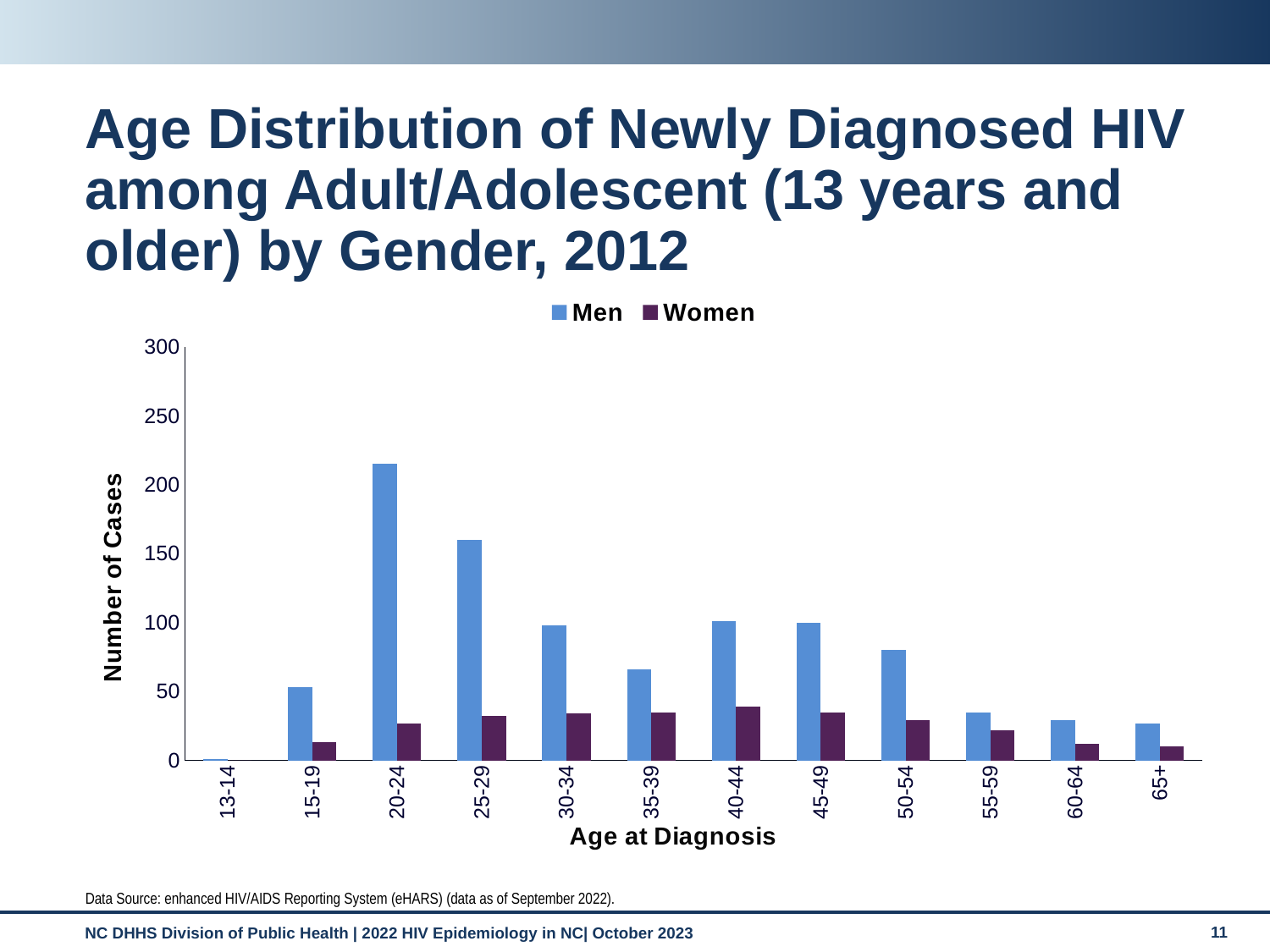
Which age group has the highest number of cases among men? 20-24 How many age groups are shown on the x axis? 12 Is the value for Men in the 25-29 age group greater or less than 150? greater How many series does the legend list? 2 What type of chart is shown on the slide? Bar chart Is the value for Men in the 55-59 age group greater or less than 50? less What is the title of the vertical axis? Number of Cases Is the value for Women in the 20-24 age group greater or less than 50? less Which is larger for Men: the 20-24 age group or the 25-29 age group? 20-24 In the 30-34 age group, which series has the larger value, Men or Women? Men Which age group has the lowest number of cases among men? 13-14